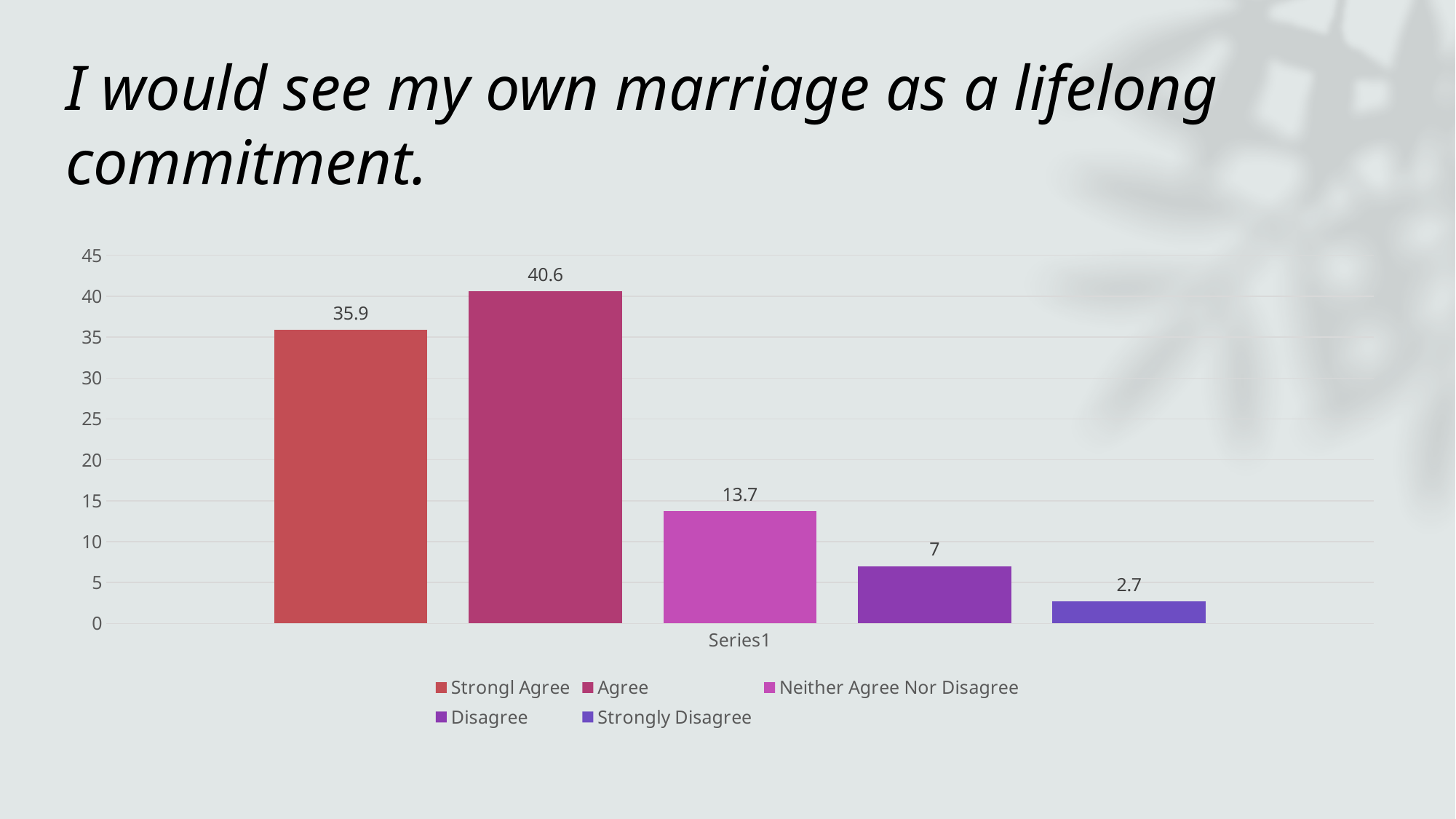
Which response has the highest value? Agree Which response has the lowest value? Strongly Disagree What is the value for Strongly Disagree? 2.7 Which is larger, the value for Neither Agree Nor Disagree or the value for Disagree? Neither Agree Nor Disagree Is the value for Strongl Agree greater or less than 30? greater What kind of chart is shown on the slide? bar chart What is the difference between the values for Agree and Strongl Agree? 4.7 What is the value for Neither Agree Nor Disagree? 13.7 How many entries does the legend list? 5 How many bars are shown in the chart? 5 What is the value for Agree? 40.6 What is the value for Disagree? 7